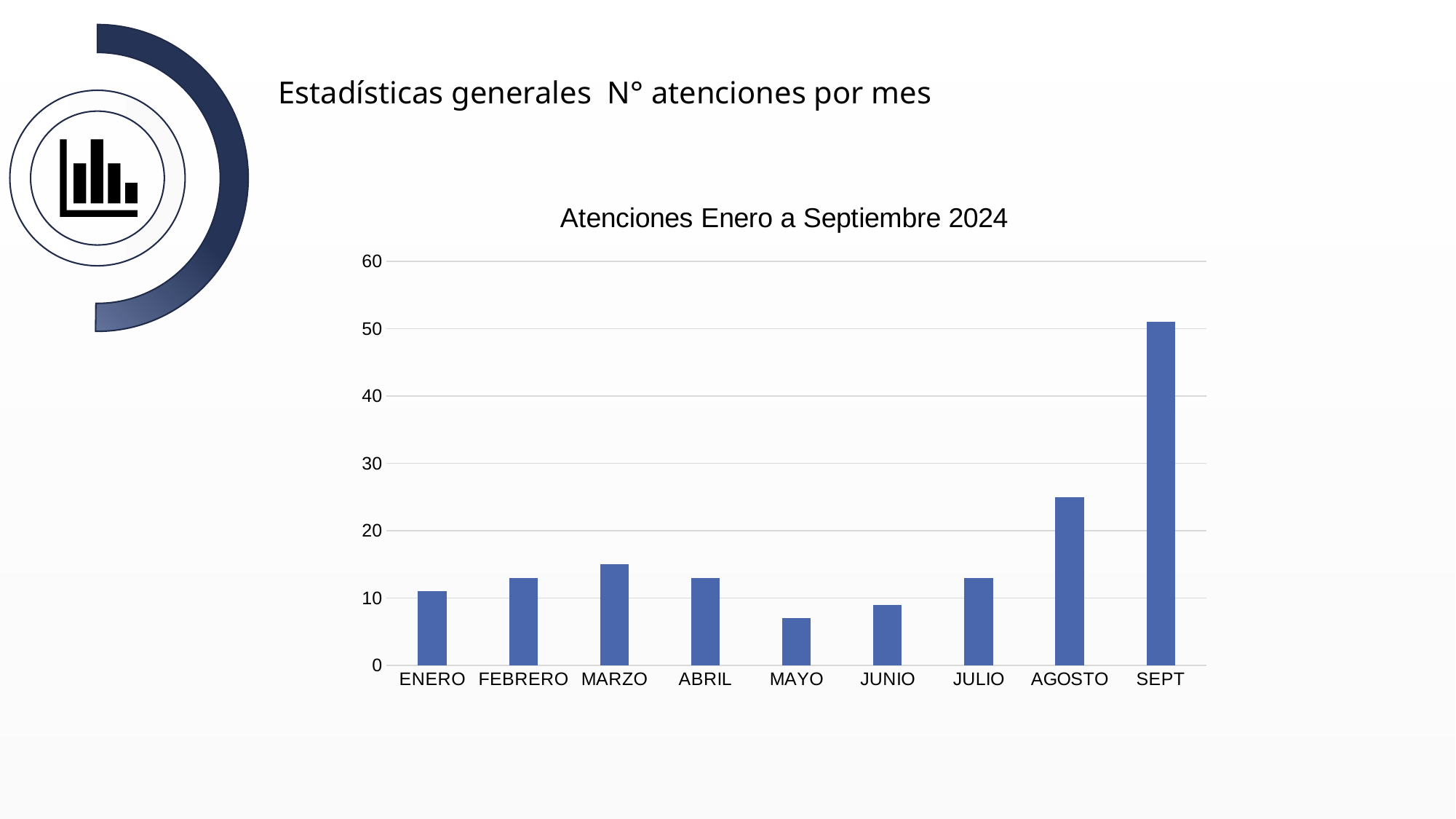
What is the title of the chart? Atenciones Enero a Septiembre 2024 Is the value for AGOSTO greater or less than 20? greater Which month has the highest number of atenciones? SEPT How many months are shown on the x axis of the chart? 9 Is the value for MAYO greater or less than 10? less Which is larger, the value for AGOSTO or the value for MARZO? AGOSTO Which is larger, the value for ENERO or the value for MAYO? ENERO Which month has the lowest number of atenciones? MAYO Is the value for MARZO greater or less than 10? greater Do the values rise or fall from JULIO to SEPT? rise What type of chart is shown on the slide? bar chart